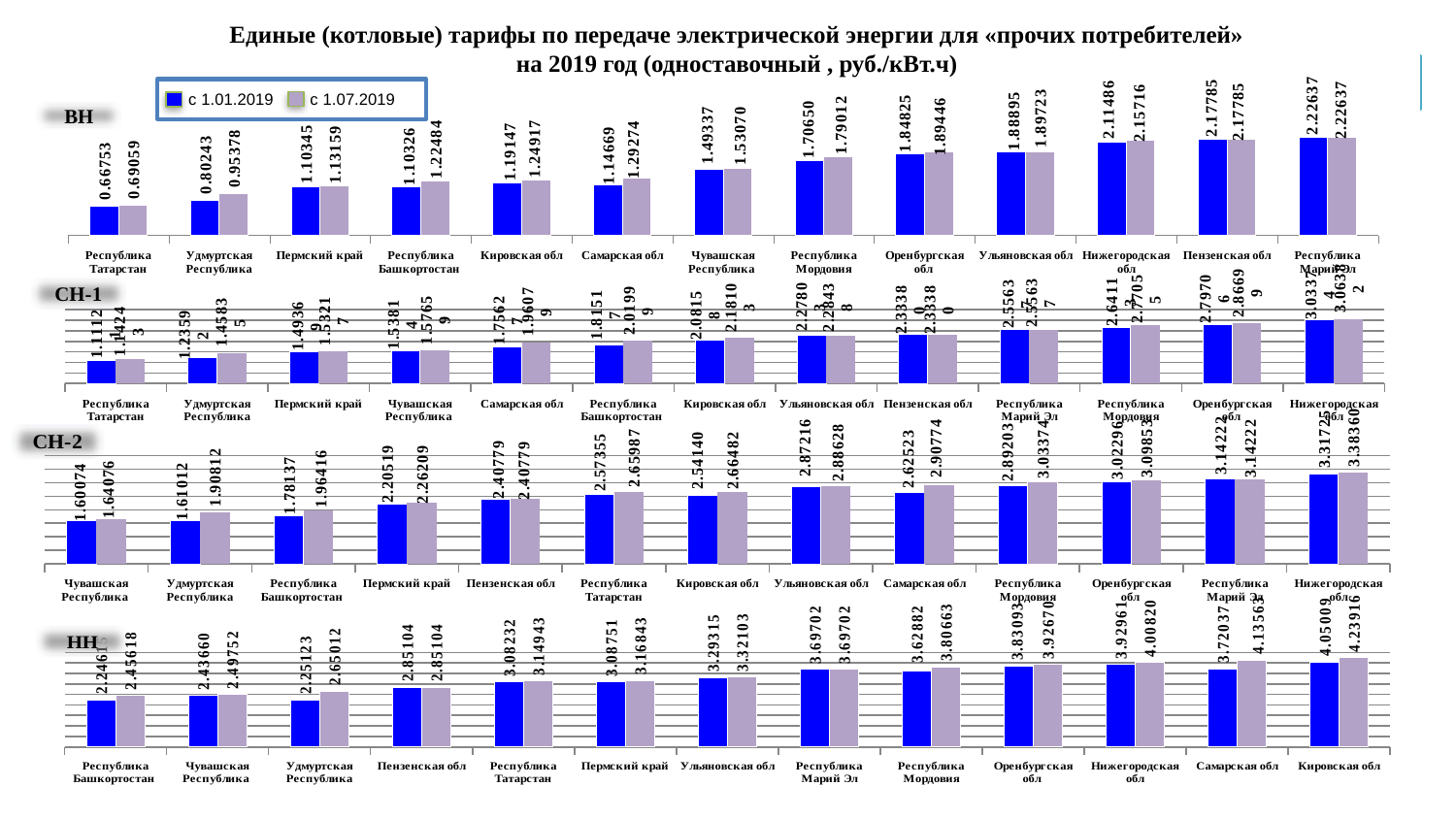
On the ВН chart, which region has the lowest value for с 1.01.2019? Республика Татарстан On the ВН chart, what kind of chart is used to show the tariffs? bar chart On the НН chart, what is the value for Кировская обл for с 1.01.2019? 4.05009 How many regions are shown on the ВН chart? 13 On the СН-2 chart, what is the value for Нижегородская обл for с 1.07.2019? 3.38360 On the ВН chart, what is the value for Нижегородская обл for с 1.07.2019? 2.15716 On the ВН chart, what is the value for Республика Татарстан for с 1.01.2019? 0.66753 On the СН-2 chart, which is larger for с 1.07.2019: Чувашская Республика or Удмуртская Республика? Удмуртская Республика On the ВН chart, what is the difference between the с 1.07.2019 and с 1.01.2019 values for Самарская обл? 0.14605 On the ВН chart, which region has the highest value for с 1.07.2019? Республика Марий Эл How many series does the legend list on the slide? 2 On the НН chart, what is the value for Пензенская обл for с 1.07.2019? 2.85104